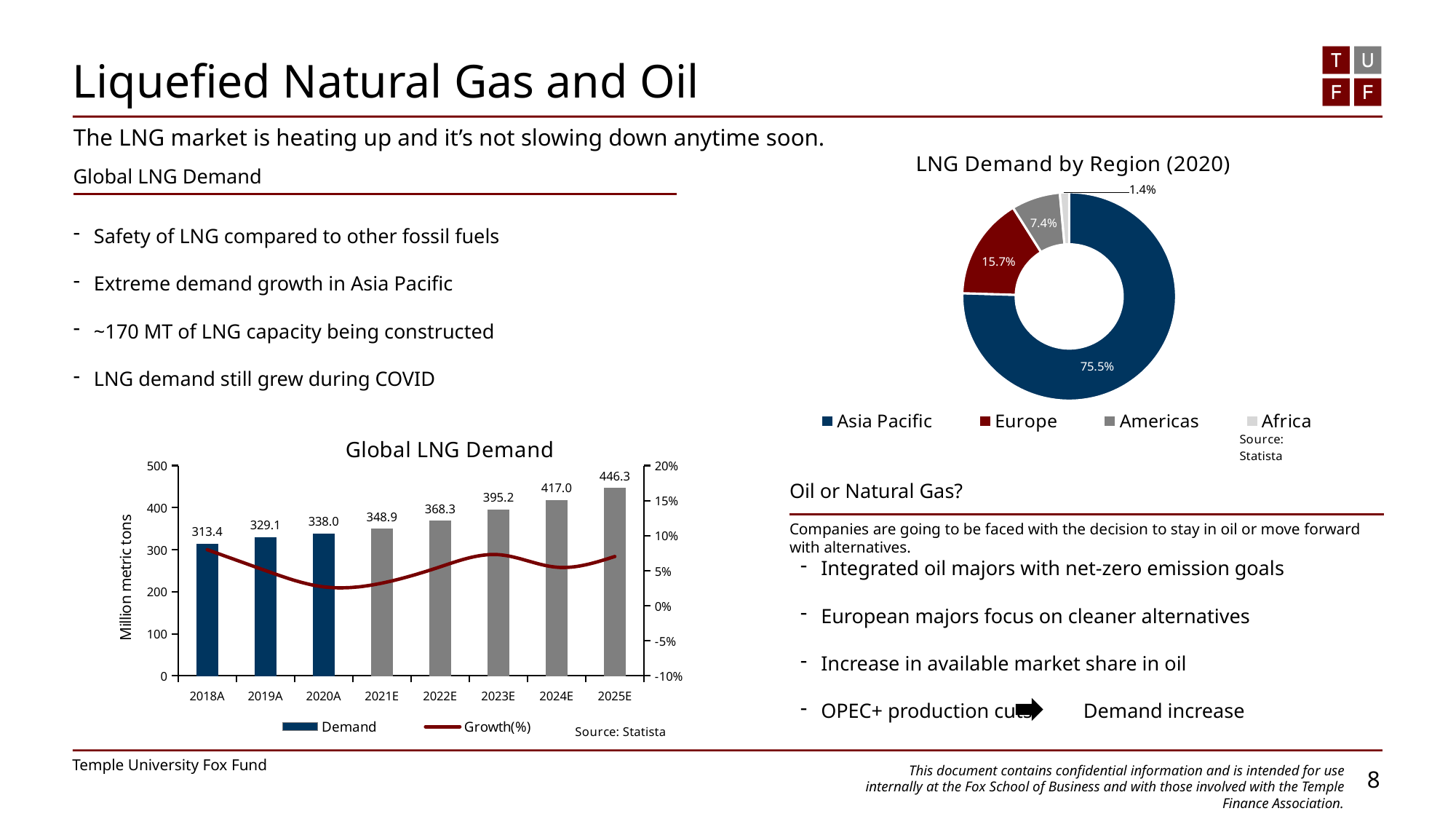
In the Global LNG Demand chart, what is the demand value for 2025E? 446.3 In the Global LNG Demand chart, what is the label of the left vertical axis? Million metric tons In the Global LNG Demand chart, how many series does the legend list? 2 In the LNG Demand by Region (2020) chart, which region has the smallest share? Africa In the Global LNG Demand chart, what is the difference between the demand values for 2025E and 2018A? 132.9 In the LNG Demand by Region (2020) chart, what share does Europe have? 15.7% In the Global LNG Demand chart, which year has the lowest demand value? 2018A In the Global LNG Demand chart, what is the demand value for 2020A? 338.0 In the Global LNG Demand chart, how many years are shown on the x axis? 8 In the Global LNG Demand chart, do the demand bars rise or fall from 2018A to 2025E? rise In the LNG Demand by Region (2020) chart, what is the difference between the shares of Europe and Americas? 8.3% In the LNG Demand by Region (2020) chart, which region has the largest share? Asia Pacific